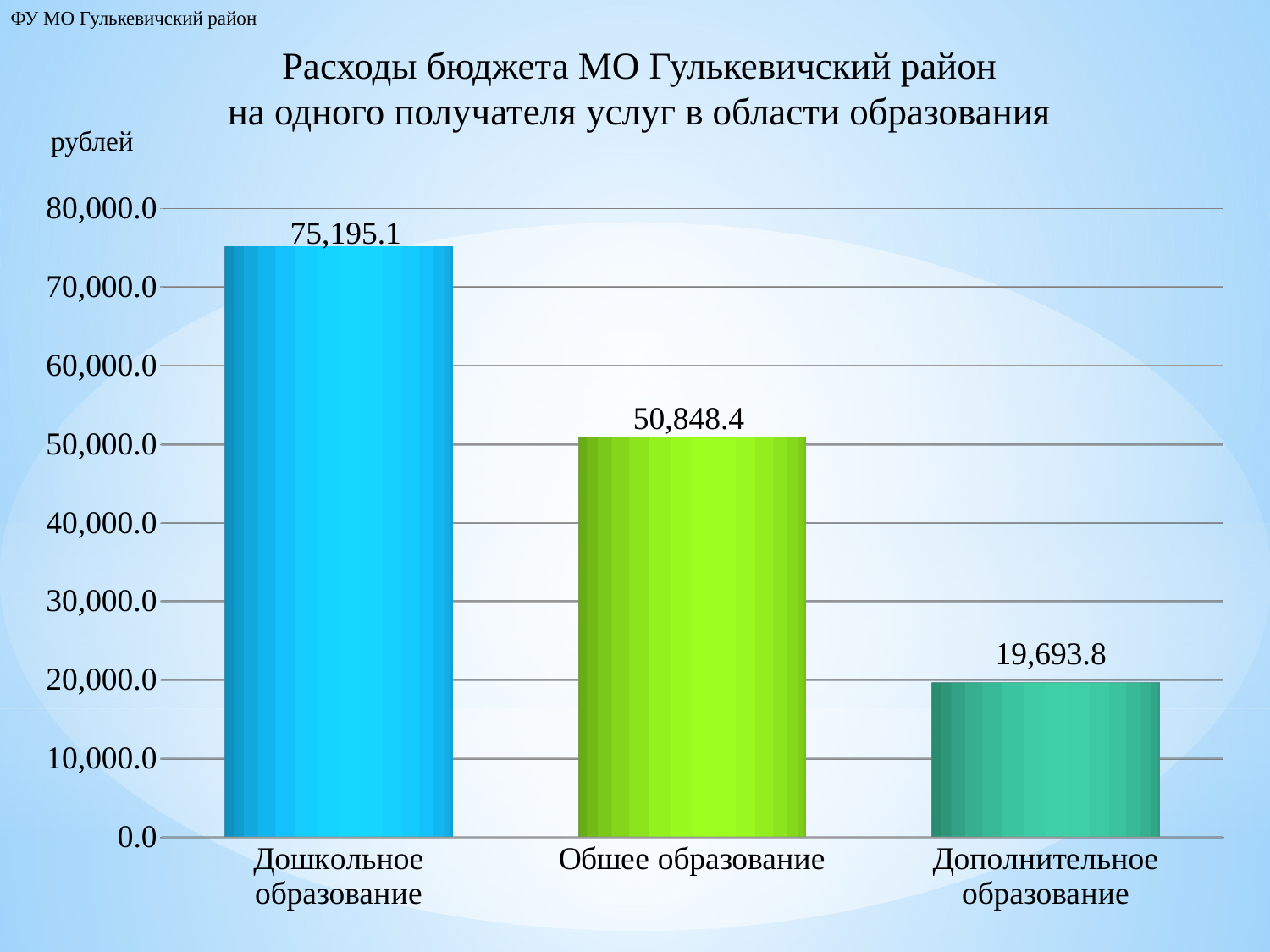
Каково значение для категории «Дошкольное образование»? 75,195.1 Каково значение для категории «Дополнительное образование»? 19,693.8 Что больше: значение для «Общее образование» или для «Дополнительное образование»? Общее образование Значение для «Общее образование» больше или меньше 60,000.0? меньше На сколько значение для «Общее образование» больше значения для «Дополнительное образование»? 31,154.6 Какая категория имеет наибольшее значение? Дошкольное образование В каких единицах измерения указаны значения на оси? рублей На сколько значение для «Дошкольное образование» больше значения для «Общее образование»? 24,346.7 Сколько категорий показано на диаграмме? 3 Какая категория имеет наименьшее значение? Дополнительное образование Каково значение для категории «Общее образование»? 50,848.4 Какой это тип диаграммы? столбчатая (bar chart)